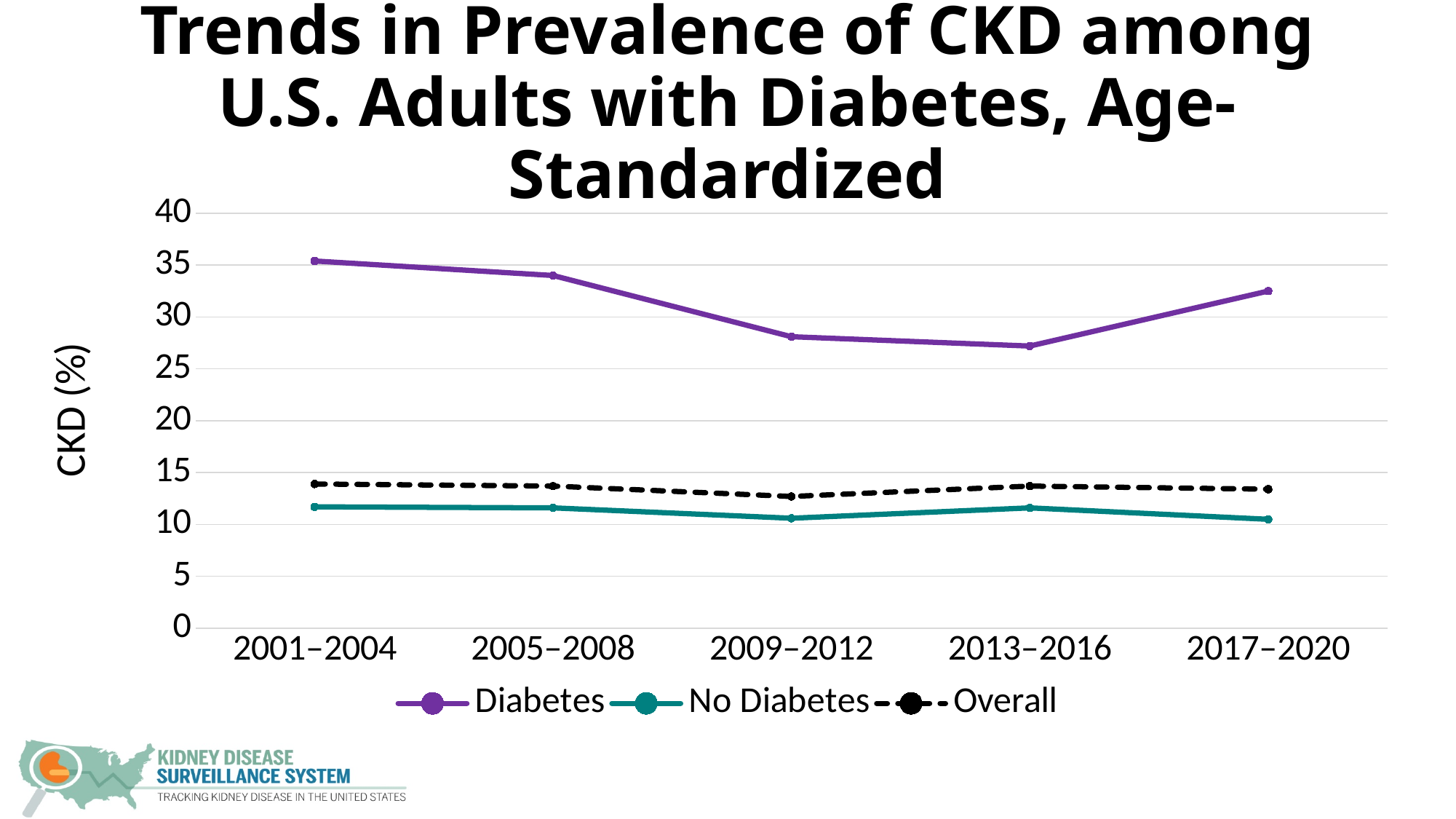
Which series has the larger value in 2017–2020, Diabetes or No Diabetes? Diabetes What is the label on the y axis? CKD (%) What kind of chart is shown on the slide? line chart Is the value for Diabetes in 2013–2016 greater or less than 30? less Does the Diabetes series rise or fall from 2001–2004 to 2013–2016? fall Which series has the larger value in 2009–2012, Overall or No Diabetes? Overall How many series does the legend list? 3 In which time period is the Diabetes series at its highest? 2001–2004 Is the value for Diabetes in 2001–2004 greater or less than 30? greater Is the value for No Diabetes in 2009–2012 greater or less than 15? less How many time periods are shown on the x axis? 5